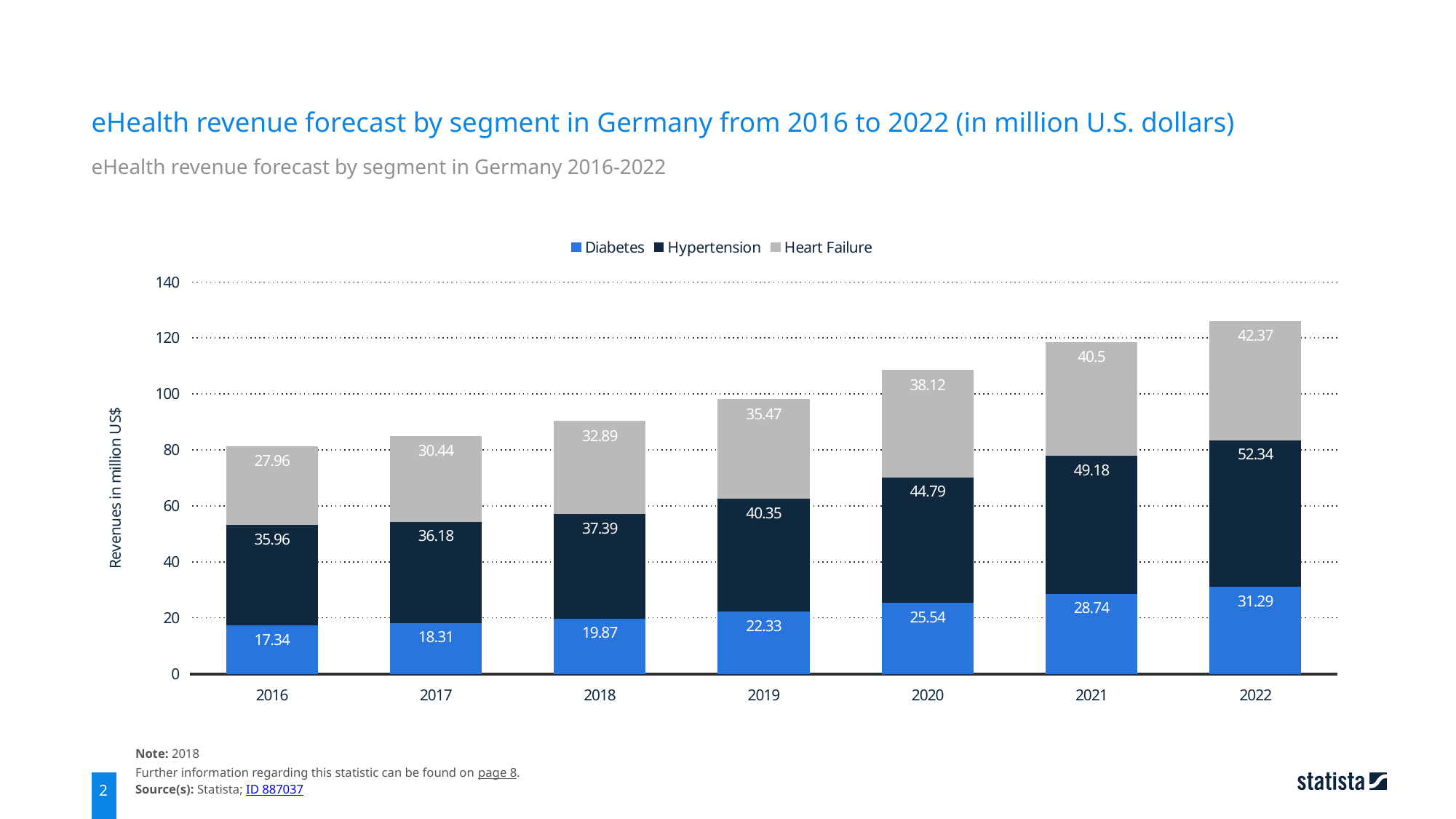
What is the Diabetes revenue forecast for 2016? 17.34 What is the total of the stacked bar for 2022? 126 Which year has the lowest Heart Failure value? 2016 What kind of chart is shown? Stacked bar chart Is the total stacked bar for 2020 greater or less than 100? greater What is the Heart Failure revenue forecast for 2021? 40.5 Which year has the highest Hypertension value? 2022 How many series does the legend list? 3 What is the difference between the Hypertension values for 2022 and 2016? 16.38 How many years are shown on the x axis? 7 Which is larger, the Diabetes value for 2019 or the Diabetes value for 2018? 2019 What is the Hypertension revenue forecast for 2020? 44.79